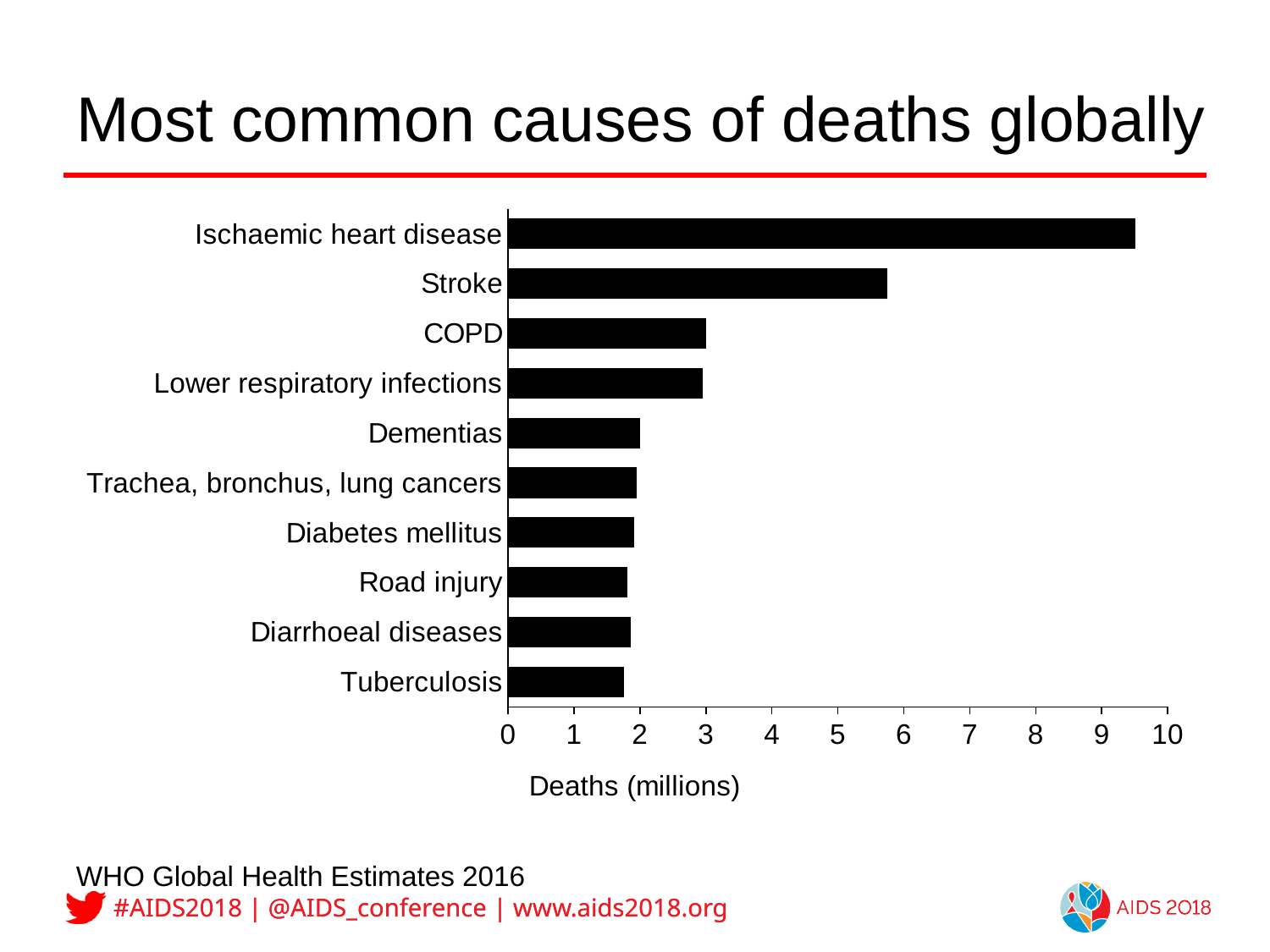
Which has more deaths, Stroke or COPD? Stroke Is the value for Stroke greater or less than 6 million deaths? less What is the label of the horizontal axis? Deaths (millions) Is the value for COPD greater or less than 2 million deaths? greater What kind of chart is shown on the slide? bar chart What is the title of the slide? Most common causes of deaths globally Is the value for Stroke greater or less than 5 million deaths? greater Which has more deaths, Ischaemic heart disease or Stroke? Ischaemic heart disease Which cause of death has the highest number of deaths in the chart? Ischaemic heart disease How many causes of death are listed in the chart? 10